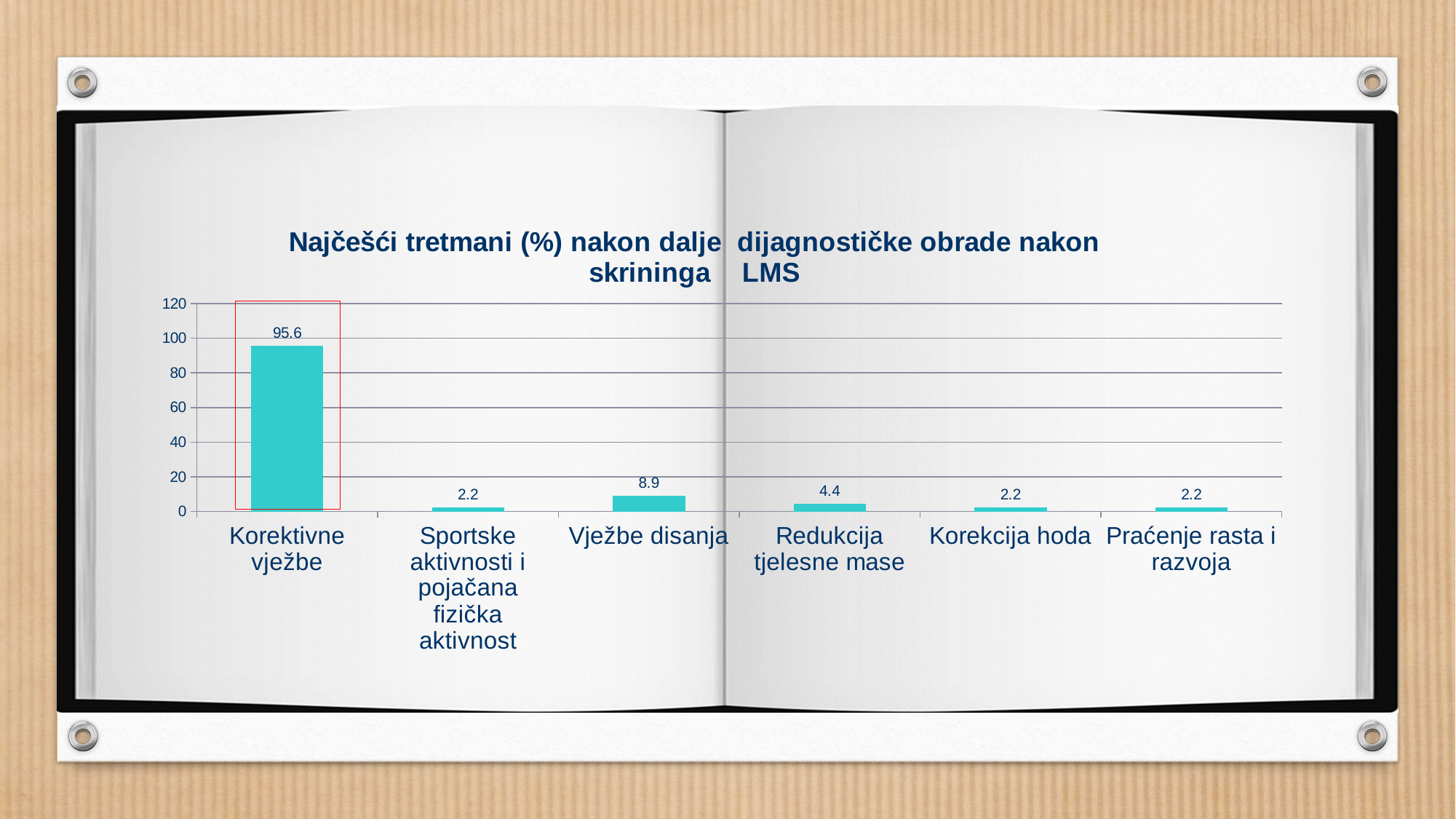
Which is larger, the value for Vježbe disanja or the value for Redukcija tjelesne mase? Vježbe disanja What is the difference between the values for Korektivne vježbe and Vježbe disanja? 86.7 What is the value for Korekcija hoda? 2.2 Which category has the highest value? Korektivne vježbe How many categories are shown on the x axis? 6 What is the difference between the values for Vježbe disanja and Redukcija tjelesne mase? 4.5 What is the value for Redukcija tjelesne mase? 4.4 What is the title of the chart? Najčešći tretmani (%) nakon dalje dijagnostičke obrade nakon skrininga LMS What is the value for Korektivne vježbe? 95.6 Is the value for Korektivne vježbe greater or less than 80? greater What is the value for Vježbe disanja? 8.9 What kind of chart is shown on the slide? bar chart